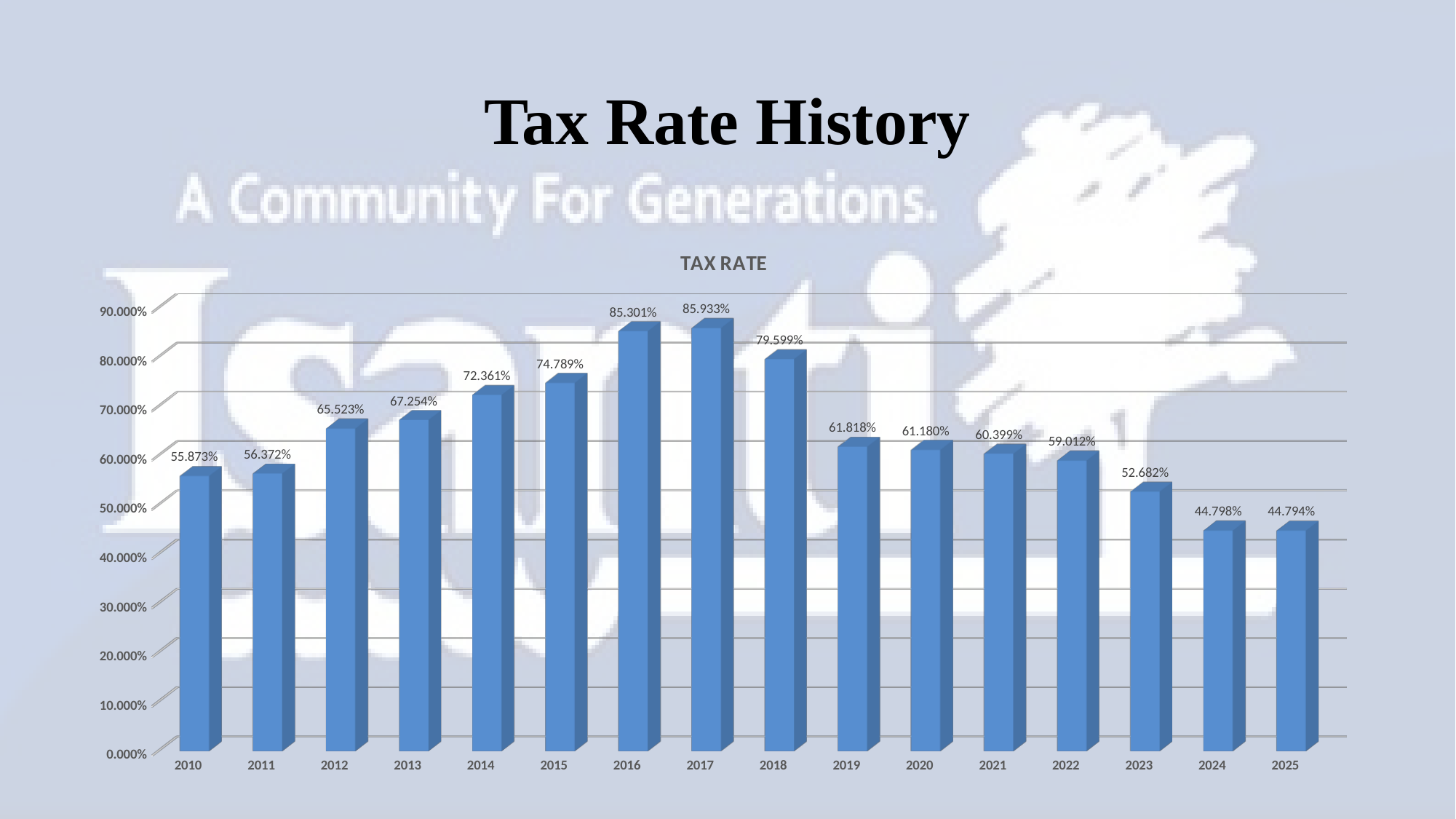
What is the tax rate for 2023? 52.682% Which year has the larger tax rate, 2012 or 2020? 2012 Do the tax rates rise or fall from 2017 to 2025? fall What is the title printed above the chart's plot area? TAX RATE What kind of chart is used to show the tax rate history? bar chart What is the difference between the tax rates for 2017 and 2016? 0.632% What is the tax rate for 2017? 85.933% What is the tax rate shown for 2010? 55.873% What is the difference between the tax rates for 2018 and 2019? 17.781% Is the tax rate for 2014 greater or less than 70.000%? greater Which year has the highest tax rate? 2017 How many years are shown on the x axis of the chart? 16